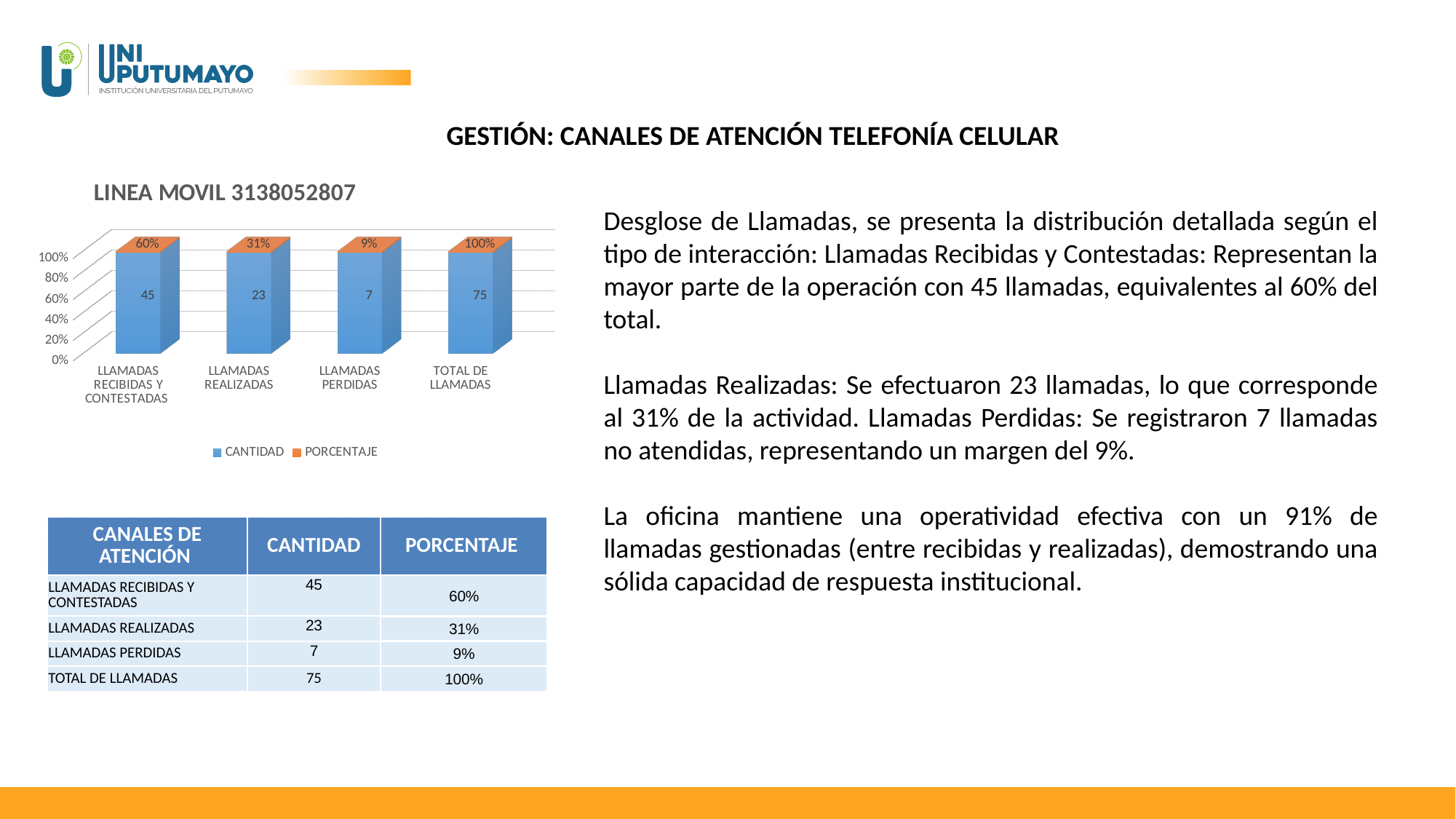
How many categories are shown on the x axis of the chart? 4 What is the title of the chart? LINEA MOVIL 3138052807 What type of chart is shown on the slide? Bar chart Excluding TOTAL DE LLAMADAS, which category has the highest CANTIDAD value? LLAMADAS RECIBIDAS Y CONTESTADAS How many series does the chart legend list? 2 Which series is shown in orange in the chart legend? PORCENTAJE What is the CANTIDAD value for LLAMADAS PERDIDAS? 7 What is the PORCENTAJE value for TOTAL DE LLAMADAS? 100% What is the difference between the CANTIDAD values for LLAMADAS RECIBIDAS Y CONTESTADAS and LLAMADAS REALIZADAS? 22 Which category has the lowest CANTIDAD value? LLAMADAS PERDIDAS What is the CANTIDAD value for LLAMADAS RECIBIDAS Y CONTESTADAS? 45 What is the PORCENTAJE value for LLAMADAS REALIZADAS? 31%